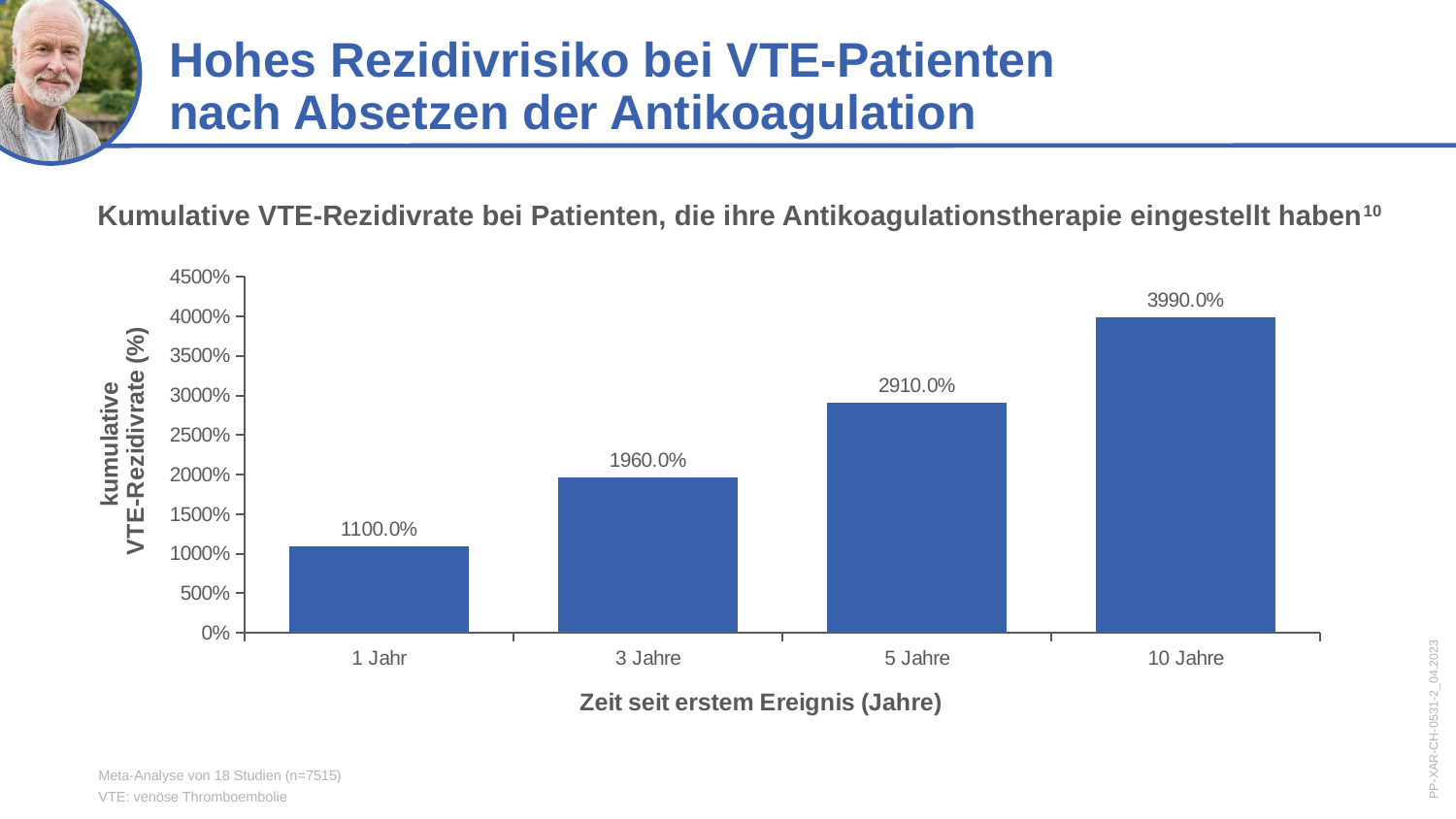
What value is labelled on the bar for 5 Jahre? 2910.0% What is the difference between the values for 5 Jahre and 3 Jahre? 950.0% Which category has the highest value in the chart? 10 Jahre What is the difference between the values for 10 Jahre and 1 Jahr? 2890.0% Which is larger, the value for 3 Jahre or the value for 5 Jahre? 5 Jahre How many categories are shown on the x axis of the chart? 4 Do the values rise or fall as time since the first event increases along the x axis? Rise What kind of chart is shown on the slide? Bar chart What is the cumulative VTE recurrence rate shown for 1 Jahr? 1100.0% What value is labelled on the bar for 10 Jahre? 3990.0% Which category has the lowest value in the chart? 1 Jahr What value is labelled on the bar for 3 Jahre? 1960.0%